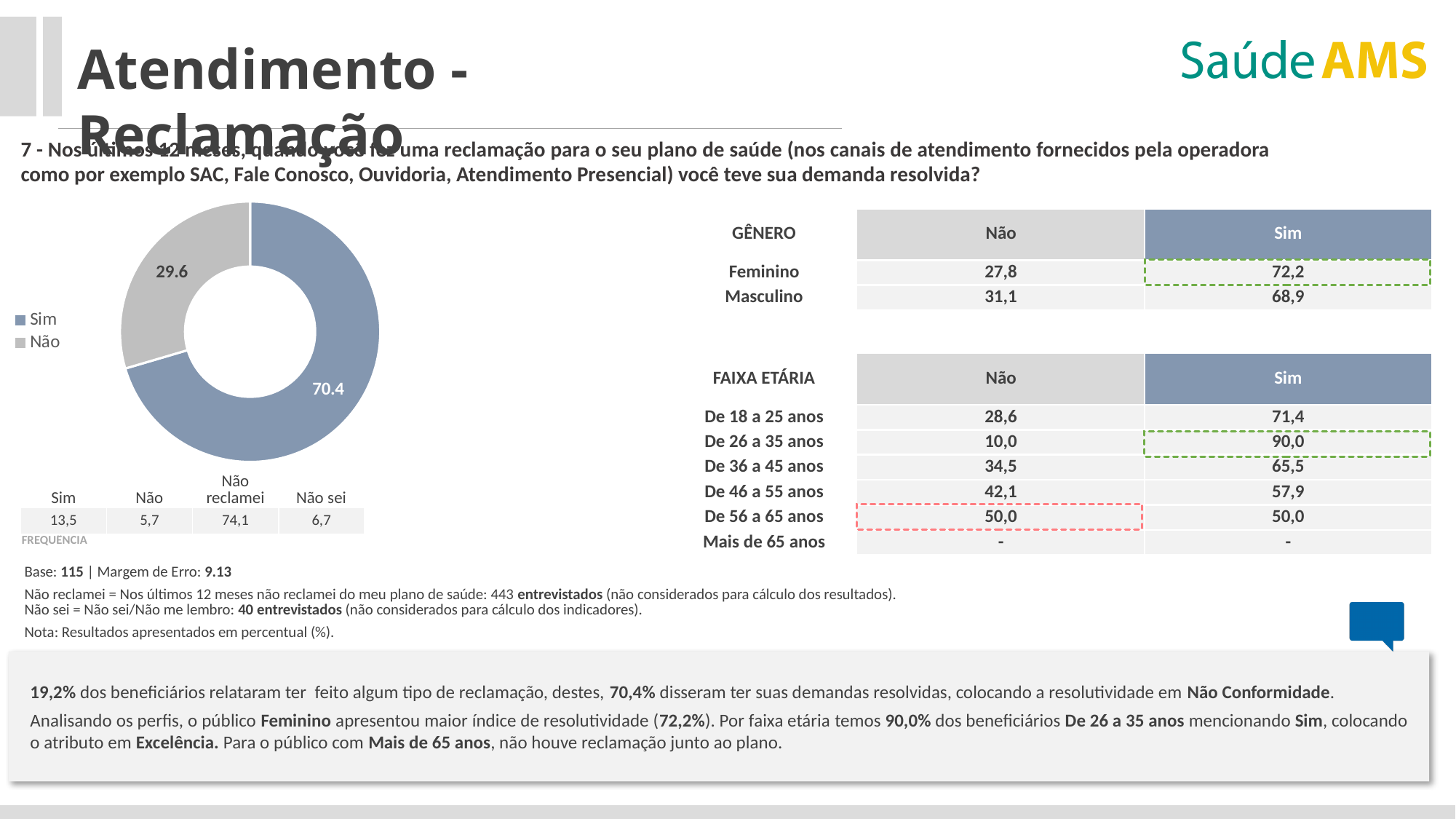
What are the two legend entries of the donut chart? Sim and Não In the donut chart, what is the value shown for Sim? 70.4 In the donut chart, which is larger: Sim or Não? Sim What kind of chart is shown on the left of the slide? Donut chart In the donut chart, what is the value shown for Não? 29.6 How many slices does the donut chart have? 2 Which slice of the donut chart is the smallest? Não What colour is the Sim slice in the donut chart? Blue-grey How many entries does the legend of the donut chart list? 2 Which slice of the donut chart is the largest? Sim What share of the donut chart does the Não slice represent? 29.6 In the donut chart, what is the difference between the Sim value and the Não value? 40.8